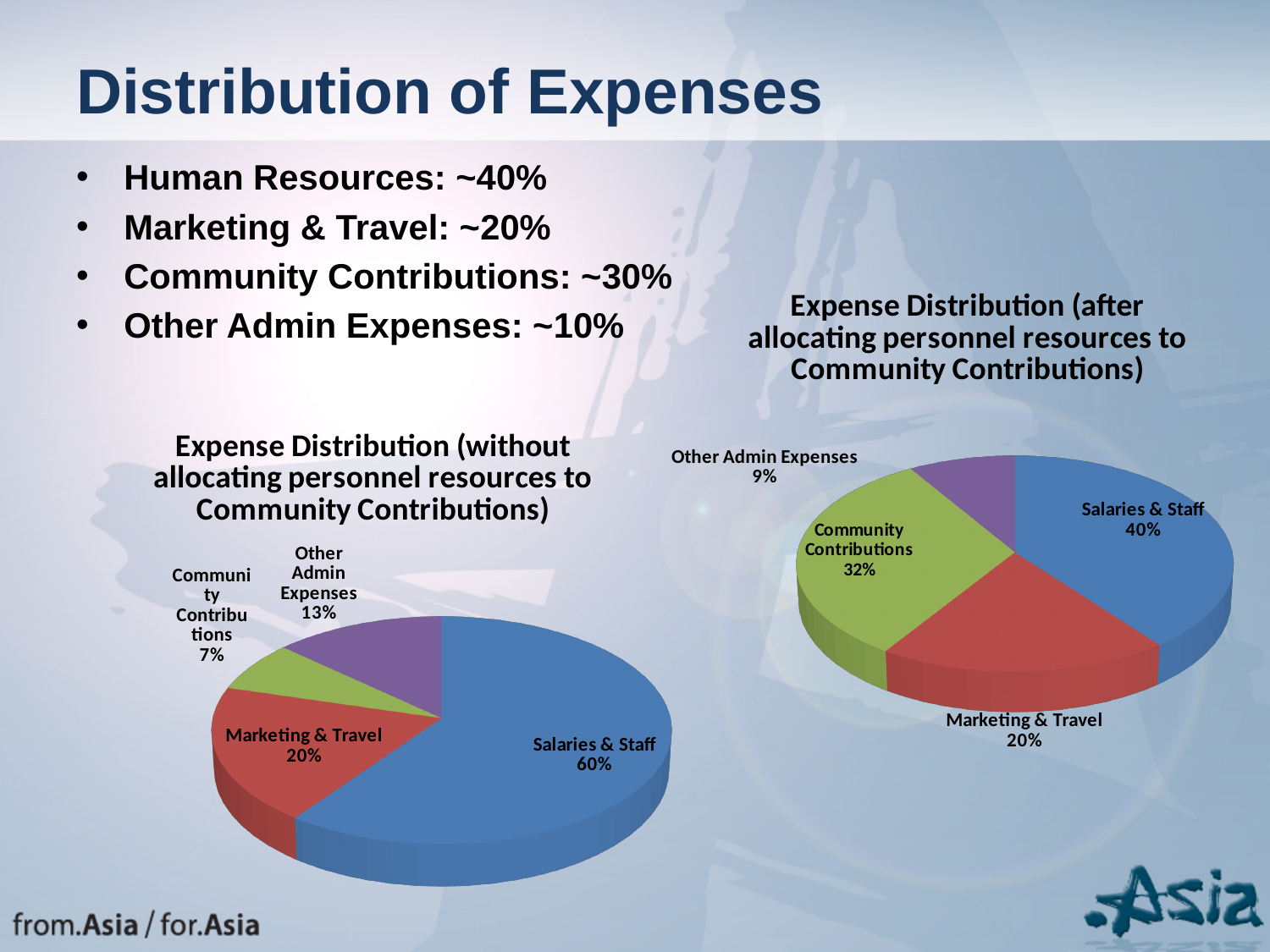
In the right chart (Expense Distribution after allocating personnel resources to Community Contributions), what share is Community Contributions? 32% What kind of chart is the left chart (Expense Distribution without allocating personnel resources to Community Contributions)? Pie chart In the left chart (Expense Distribution without allocating personnel resources to Community Contributions), how many slices does the pie have? 4 In the right chart (Expense Distribution after allocating personnel resources to Community Contributions), what is the difference between the Salaries & Staff share and the Community Contributions share? 8% In the left chart (Expense Distribution without allocating personnel resources to Community Contributions), what share is Other Admin Expenses? 13% In the right chart (Expense Distribution after allocating personnel resources to Community Contributions), which is larger, Community Contributions or Marketing & Travel? Community Contributions In the right chart (Expense Distribution after allocating personnel resources to Community Contributions), what colour is the Community Contributions slice? Green In the right chart (Expense Distribution after allocating personnel resources to Community Contributions), what share is Other Admin Expenses? 9% In the left chart (Expense Distribution without allocating personnel resources to Community Contributions), which category has the smallest share? Community Contributions In the left chart (Expense Distribution without allocating personnel resources to Community Contributions), what share is Salaries & Staff? 60% In the right chart (Expense Distribution after allocating personnel resources to Community Contributions), which category has the largest share? Salaries & Staff In the left chart (Expense Distribution without allocating personnel resources to Community Contributions), what is the difference between the Salaries & Staff share and the Marketing & Travel share? 40%